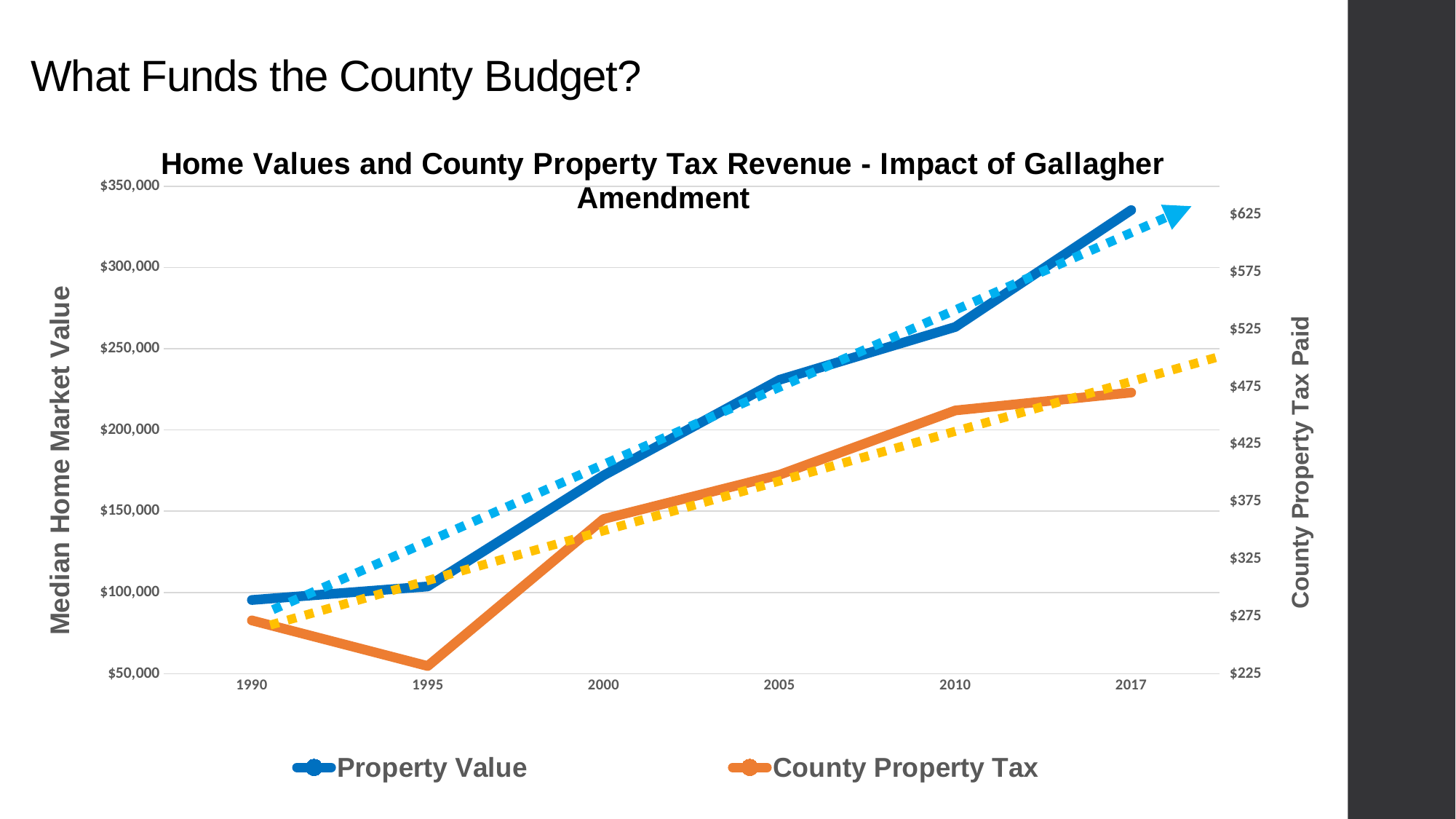
How many series does the legend list? 2 How many years are plotted along the x axis? 6 Is the Property Value for 1990 greater or less than $100,000? less What is the label of the right-hand vertical axis? County Property Tax Paid Does the Property Value line generally rise or fall from 1990 to 2017? rise In which year is the County Property Tax line at its lowest? 1995 Is the County Property Tax for 2010 greater or less than $425? greater Is the Property Value for 2017 greater or less than $300,000? greater In which year is the Property Value line at its highest? 2017 Does the County Property Tax line rise or fall between 1990 and 1995? fall What kind of chart is shown on the slide? Line chart